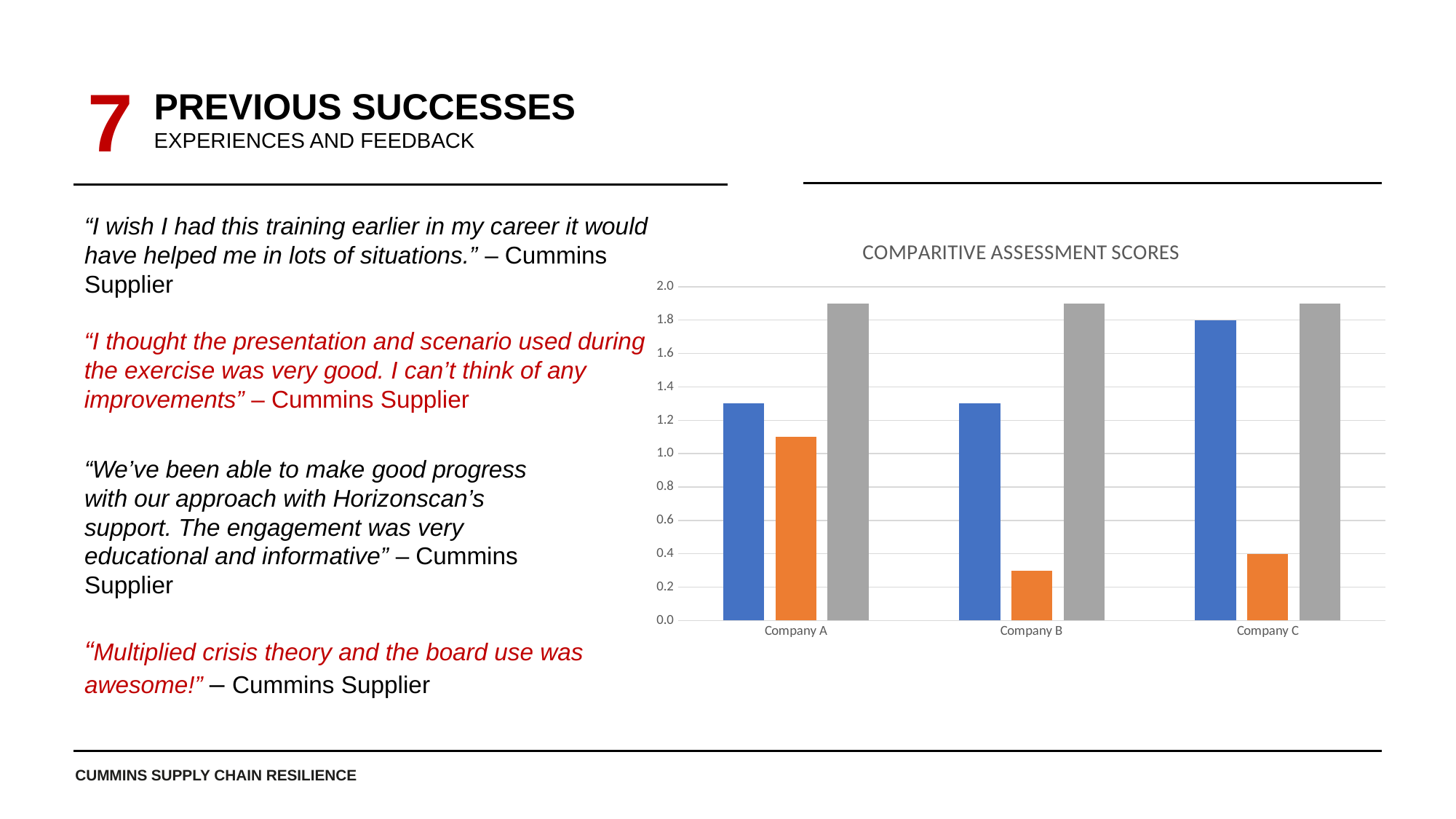
How many companies are shown on the x axis of the chart? 3 What is the title of the chart? COMPARITIVE ASSESSMENT SCORES Which company has the lowest orange bar? Company B For Company A, which is larger: the blue bar or the orange bar? the blue bar Which colour of bar is the tallest for every company in the chart? grey What kind of chart is shown on the slide? bar chart Is the grey bar for Company C greater or less than 1.8? greater How many bars are shown for each company in the chart? 3 Is the blue bar for Company A greater or less than 1.2? greater Which company has the highest blue bar? Company C Is the orange bar for Company A greater or less than 1.0? greater